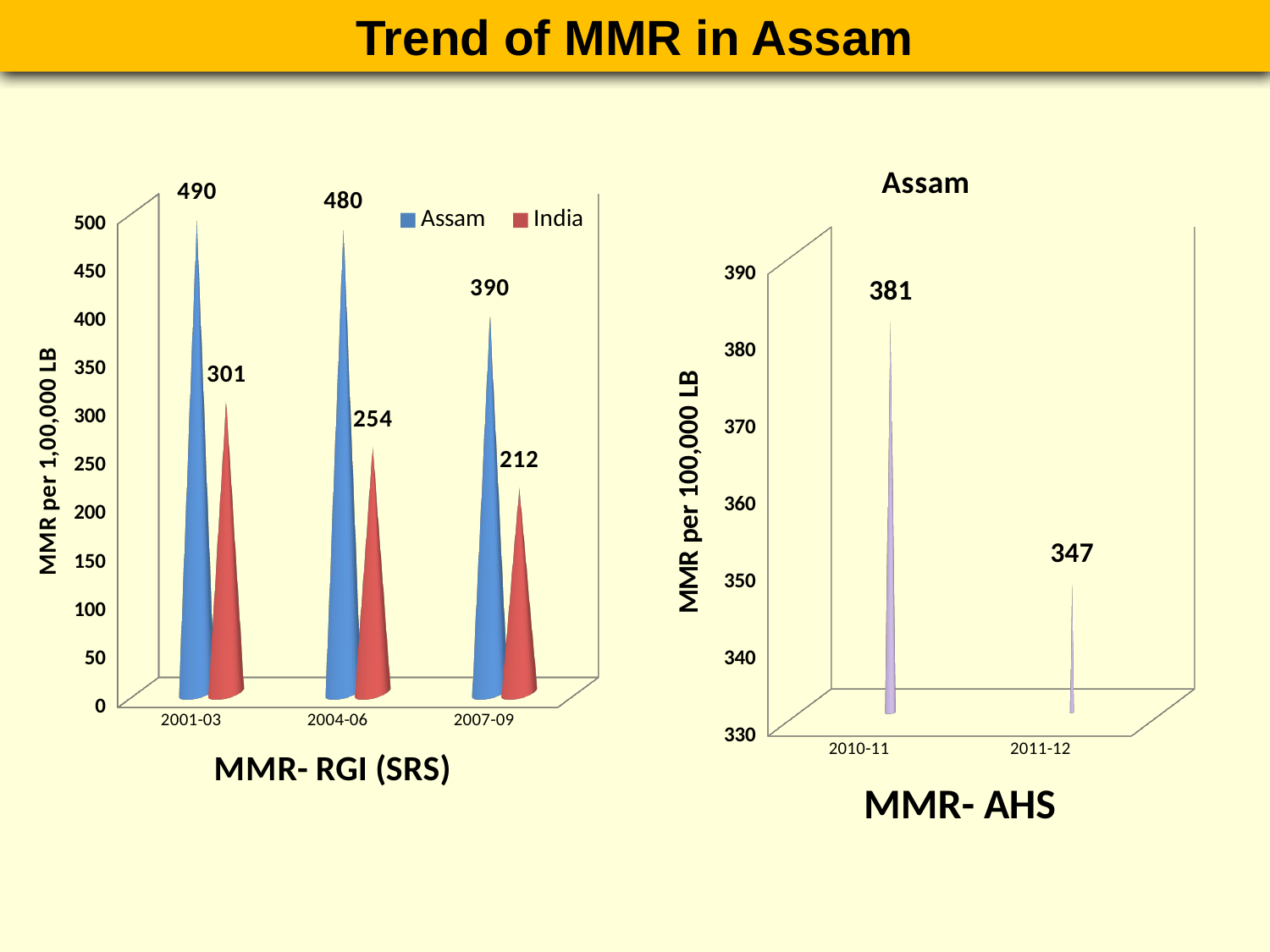
In the MMR- RGI (SRS) chart on the left, which is larger in 2007-09, the Assam value or the India value? Assam In the MMR- RGI (SRS) chart on the left, what is the MMR for India in 2004-06? 254 In the MMR- RGI (SRS) chart on the left, what is the difference between the Assam and India values in 2001-03? 189 In the MMR- RGI (SRS) chart on the left, what is the MMR for Assam in 2001-03? 490 In the MMR- RGI (SRS) chart on the left, do the Assam values rise or fall from 2001-03 to 2007-09? fall In the MMR- AHS chart on the right, what is the MMR for 2010-11? 381 In the MMR- AHS chart on the right, how many periods are plotted on the x axis? 2 In the MMR- RGI (SRS) chart on the left, what is the MMR for Assam in 2007-09? 390 In the MMR- AHS chart on the right, what is the difference between the 2010-11 and 2011-12 values? 34 In the MMR- RGI (SRS) chart on the left, which period has the lowest value for India? 2007-09 In the MMR- AHS chart on the right, what is the MMR for 2011-12? 347 In the MMR- RGI (SRS) chart on the left, how many series does the legend list? 2